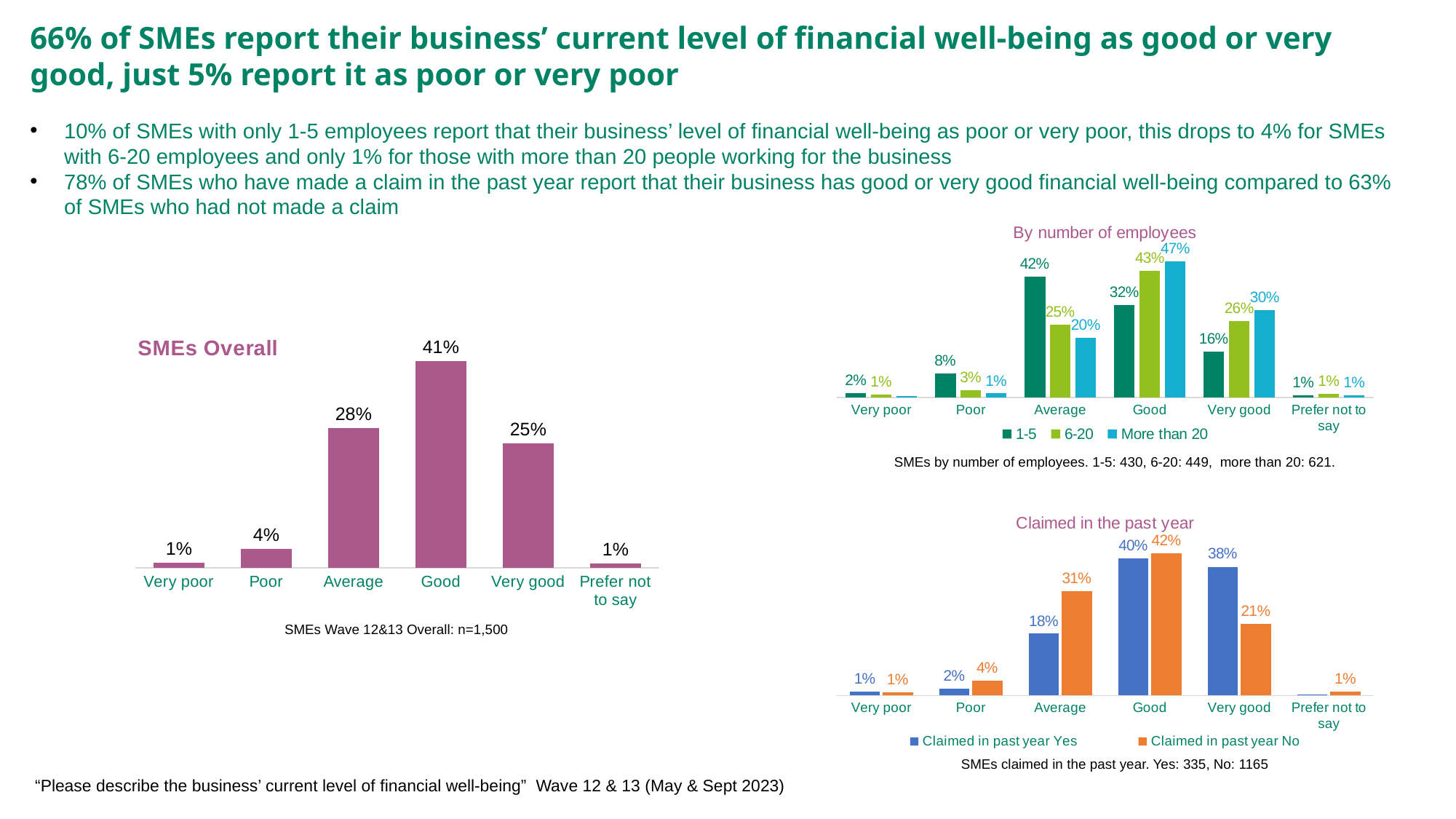
In the 'By number of employees' chart, what is the difference between the 1-5 and 6-20 values for Poor? 5% In the 'SMEs Overall' chart, what is the difference between the Average and Very good values? 3% In the 'By number of employees' chart, what is the value for Average among SMEs with 1-5 employees? 42% What type of chart is the 'SMEs Overall' chart? Bar chart In the 'By number of employees' chart, which employee-size group has the highest value for Good? More than 20 In the 'SMEs Overall' chart, which category has the highest value? Good In the 'Claimed in the past year' chart, what is the difference between the Yes and No values for Very good? 17% In the 'Claimed in the past year' chart, which is larger for Average: Claimed in past year Yes or Claimed in past year No? Claimed in past year No In the 'SMEs Overall' chart, how many categories are shown on the x axis? 6 In the 'Claimed in the past year' chart, what is the value for Very good among SMEs that claimed in the past year (Yes)? 38% In the 'SMEs Overall' chart, what percentage of SMEs rate their financial well-being as Good? 41% In the 'By number of employees' chart, how many series does the legend list? 3